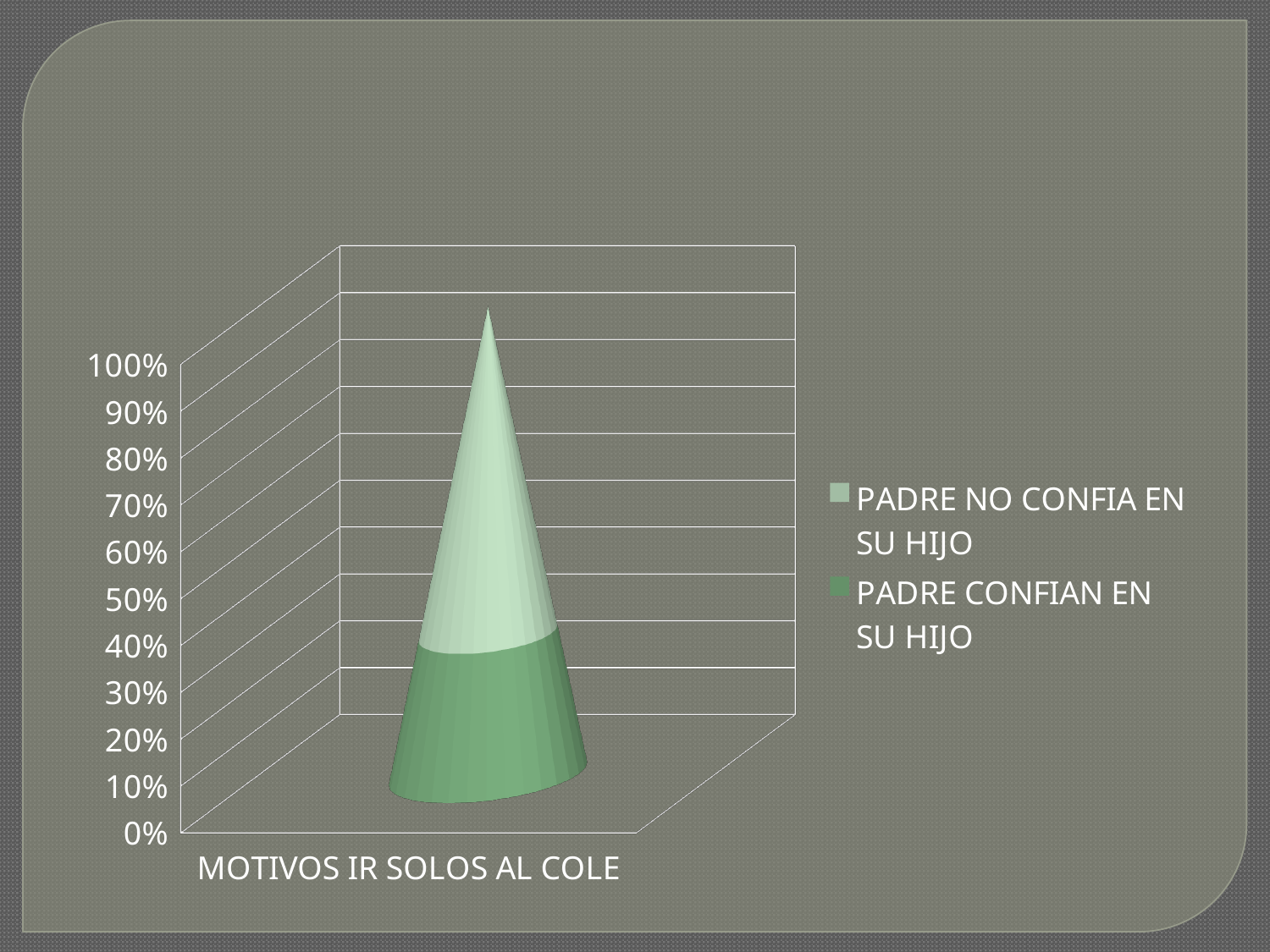
Which series takes up the larger portion of the stacked bar, PADRE NO CONFIA EN SU HIJO or PADRE CONFIAN EN SU HIJO? PADRE NO CONFIA EN SU HIJO What is the label of the category on the x axis? MOTIVOS IR SOLOS AL COLE How many categories are shown on the x axis? 1 What kind of chart is shown on the slide? bar chart Is the value for PADRE CONFIAN EN SU HIJO greater or less than 20%? greater Which series is shown in the lighter green colour in the legend? PADRE NO CONFIA EN SU HIJO Is the value for PADRE CONFIAN EN SU HIJO greater or less than 60%? less Is the value for PADRE NO CONFIA EN SU HIJO greater or less than 40%? greater How many series does the legend list? 2 What is the highest value shown on the vertical axis? 100%